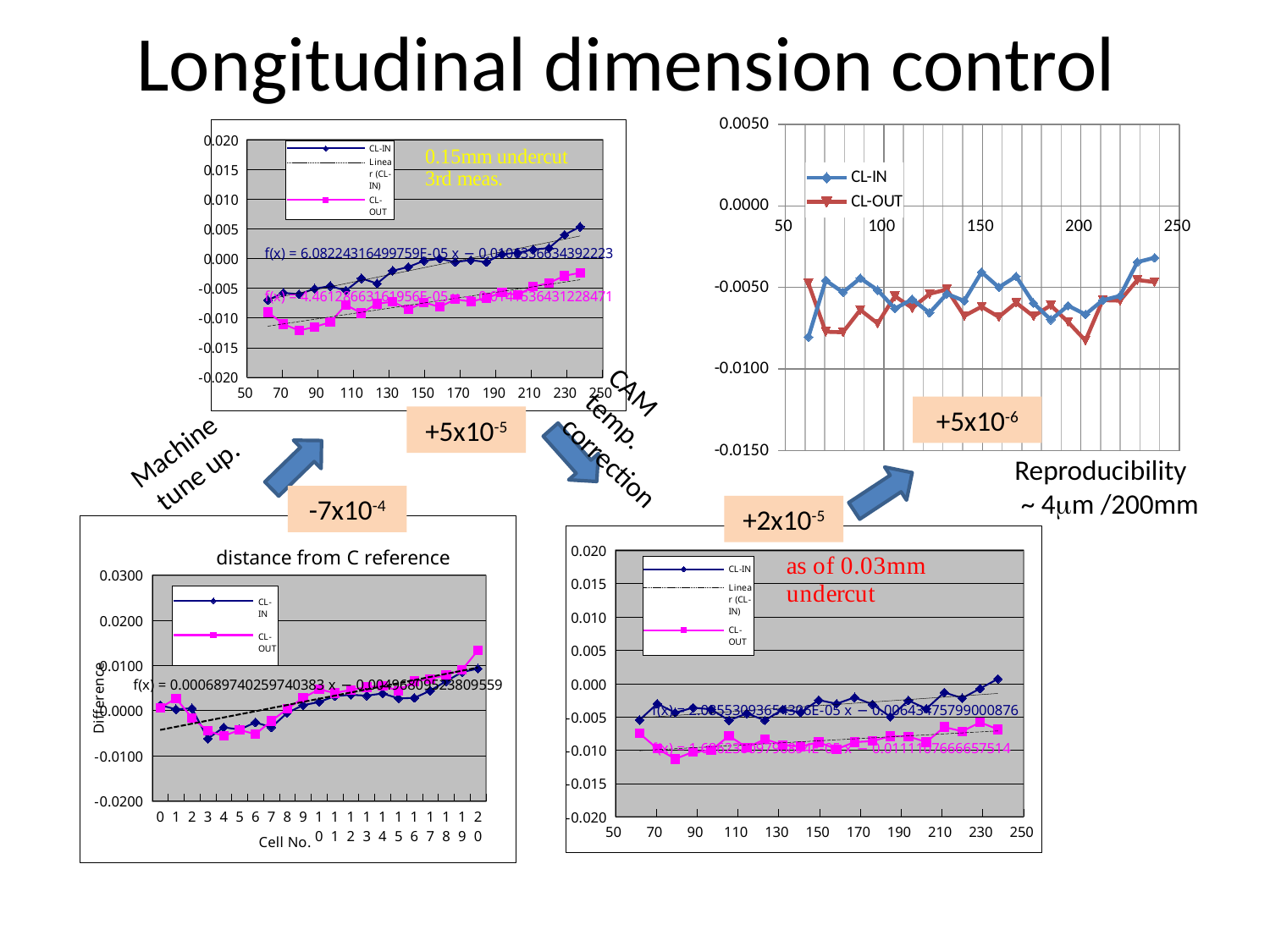
How many series does the legend of the top-left chart list? 3 In the bottom-left chart, is the CL-IN value at cell 3 greater or less than 0.0000? less What is the x-axis label of the bottom-left chart? Cell No. In the top-left chart, at x = 240, which series has the higher value, CL-IN or CL-OUT? CL-IN In the bottom-left chart, at cell 20, which series has the higher value, CL-IN or CL-OUT? CL-OUT In the top-left chart, is the CL-OUT value at x = 70 greater or less than 0.000? less What kind of chart is the top-right chart with the CL-IN and CL-OUT legend? line chart In the top-right chart, is the CL-OUT value at x = 200 greater or less than -0.0050? less What is the title of the bottom-left chart? distance from C reference How many series does the legend of the top-right chart list? 2 In the top-left chart, does the CL-IN series rise or fall along the x axis from 50 to 250? rise